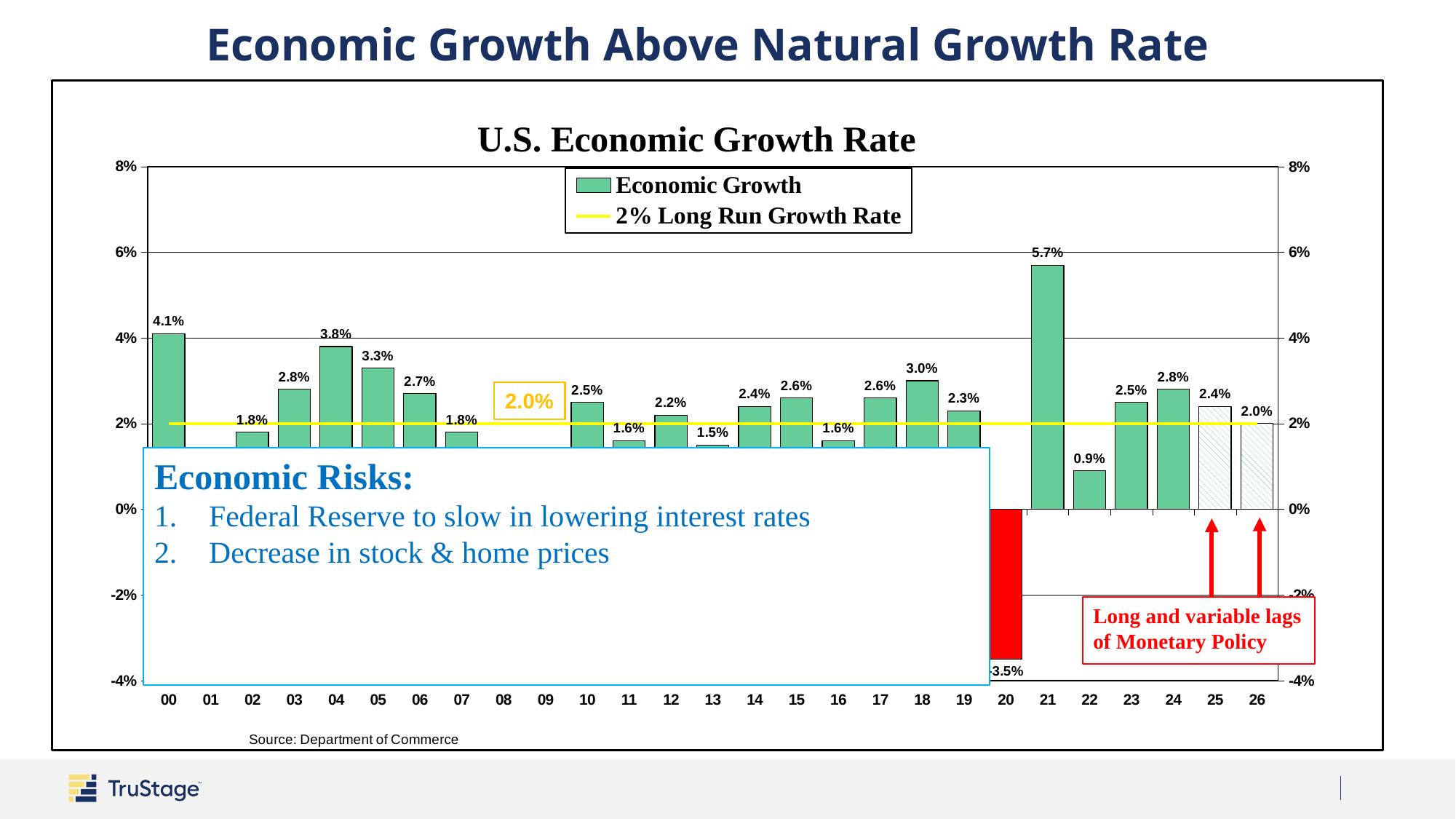
Which year has a higher economic growth rate, 18 or 19? 18 What is the title of the chart? U.S. Economic Growth Rate What is the economic growth rate shown for 26? 2.0% What is the economic growth rate shown for 21? 5.7% What type of chart is used to show Economic Growth? Bar chart What is the economic growth rate shown for 22? 0.9% What is the difference between the economic growth rate in 04 and in 05? 0.5% Which year has the highest economic growth rate? 21 What value does the yellow horizontal line represent, according to the legend? 2% Long Run Growth Rate Which year has the lowest economic growth rate? 20 How many entries does the chart legend list? 2 What is the economic growth rate shown for 00? 4.1%